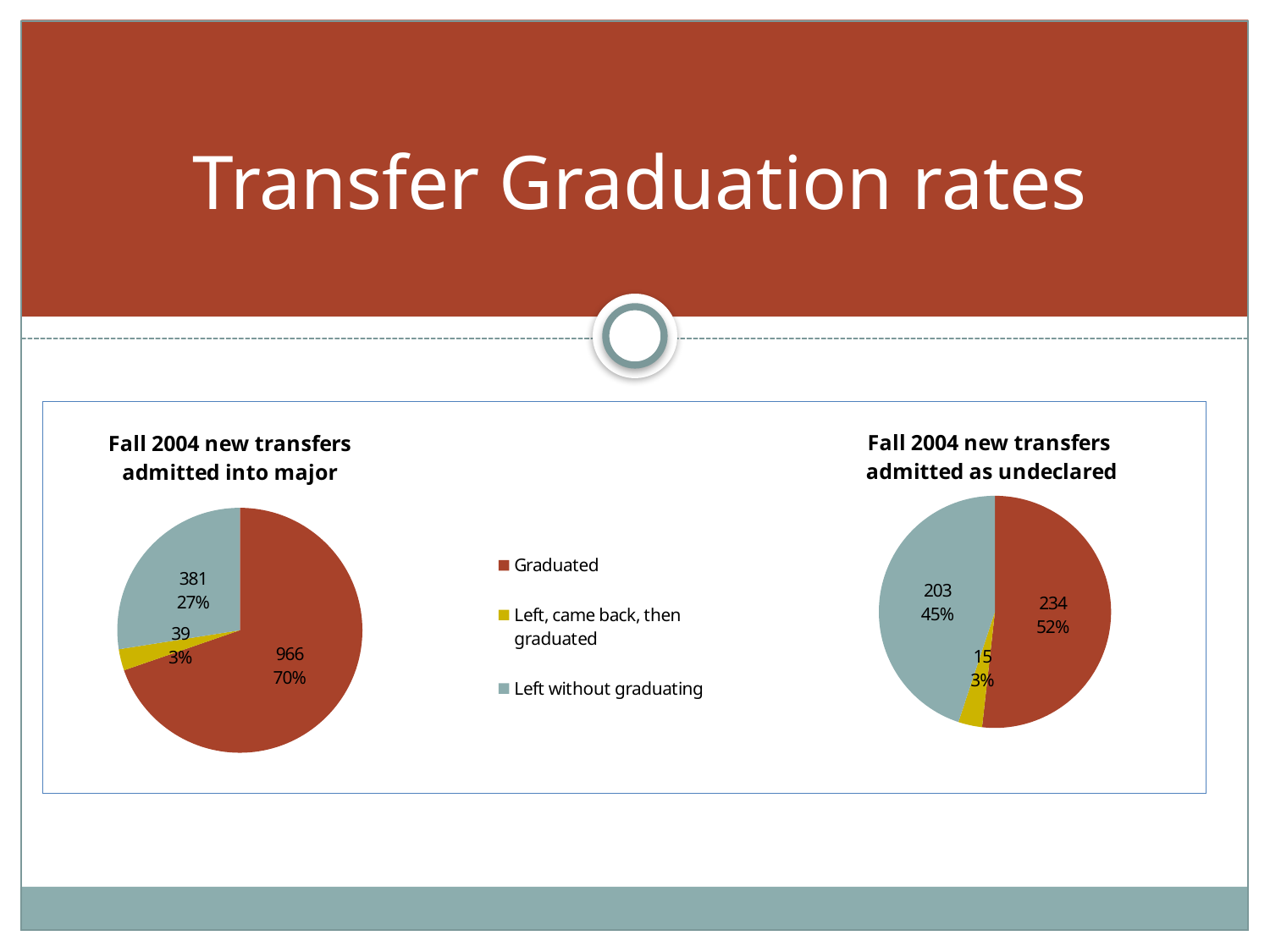
In the 'Fall 2004 new transfers admitted as undeclared' chart, what is the difference between the number who graduated and the number who left without graduating? 31 In the 'Fall 2004 new transfers admitted into major' chart, how many transfers graduated? 966 How many categories does the legend list? 3 In the 'Fall 2004 new transfers admitted as undeclared' chart, how many transfers left without graduating? 203 In the 'Fall 2004 new transfers admitted into major' chart, what is the difference between the number who graduated and the number who left without graduating? 585 In the 'Fall 2004 new transfers admitted as undeclared' chart, what share of transfers graduated? 52% What type of chart is used on this slide? Pie chart In the 'Fall 2004 new transfers admitted into major' chart, which category has the smallest slice? Left, came back, then graduated What colour represents 'Left without graduating' in the charts? Grey-blue In the 'Fall 2004 new transfers admitted as undeclared' chart, which category has the largest slice? Graduated Which chart has the larger number of transfers who left, came back, then graduated: the 'admitted into major' chart or the 'admitted as undeclared' chart? admitted into major In the 'Fall 2004 new transfers admitted into major' chart, what percentage left without graduating? 27%